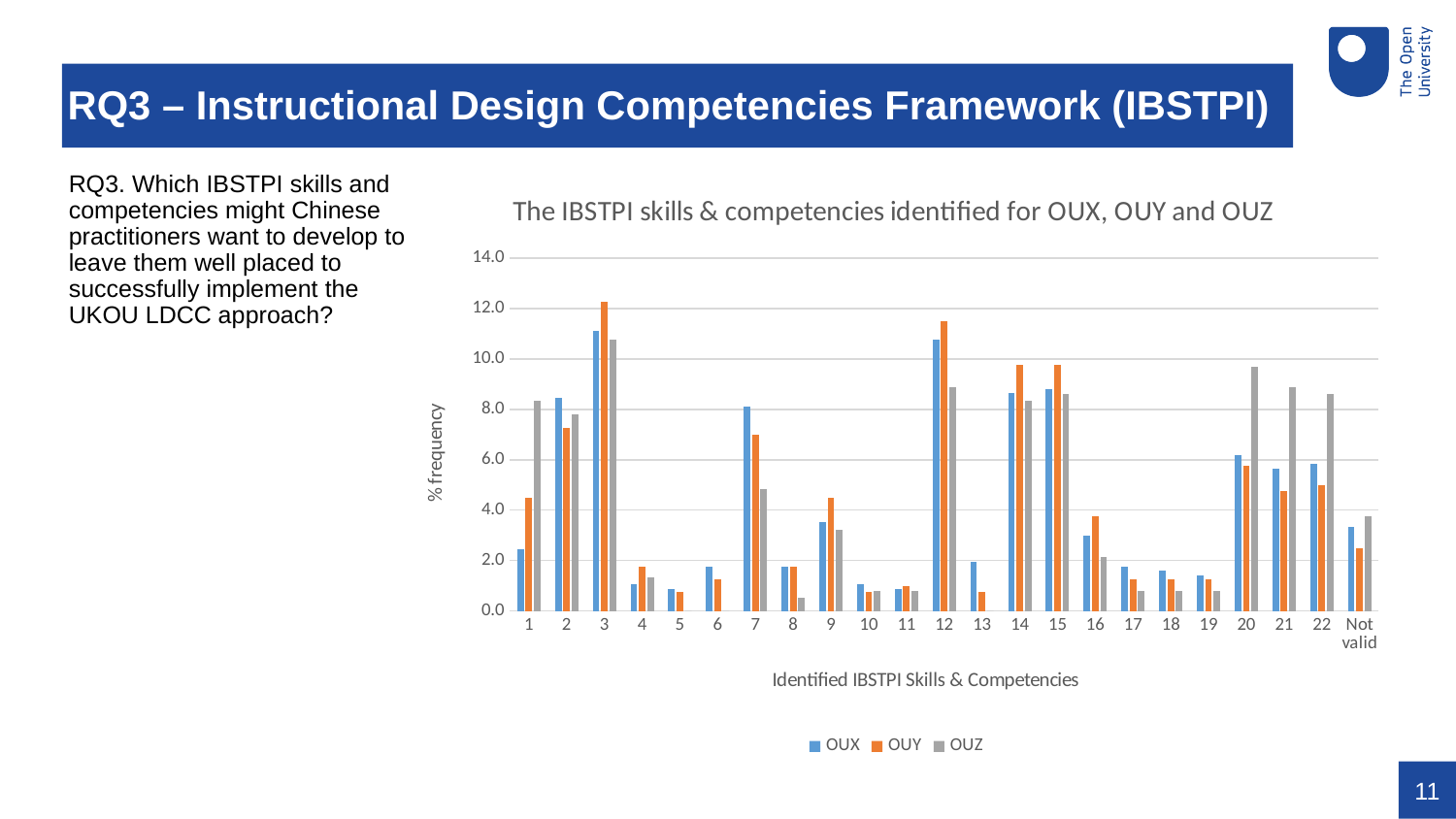
What is the title of the chart? The IBSTPI skills & competencies identified for OUX, OUY and OUZ Which category has the highest OUY value? 3 What is the label on the y axis of the chart? % frequency How many categories are shown along the x axis? 23 What kind of chart is shown on the slide? bar chart How many series does the legend list? 3 For category 1, which is larger, the OUX value or the OUZ value? OUZ For category 12, which is larger, the OUY value or the OUZ value? OUY Which category has the highest OUZ value? 3 Is the OUX value for category 1 greater or less than 4.0? less Is the OUZ value for category 20 greater or less than 8.0? greater Is the OUY value for category 3 greater or less than 10.0? greater